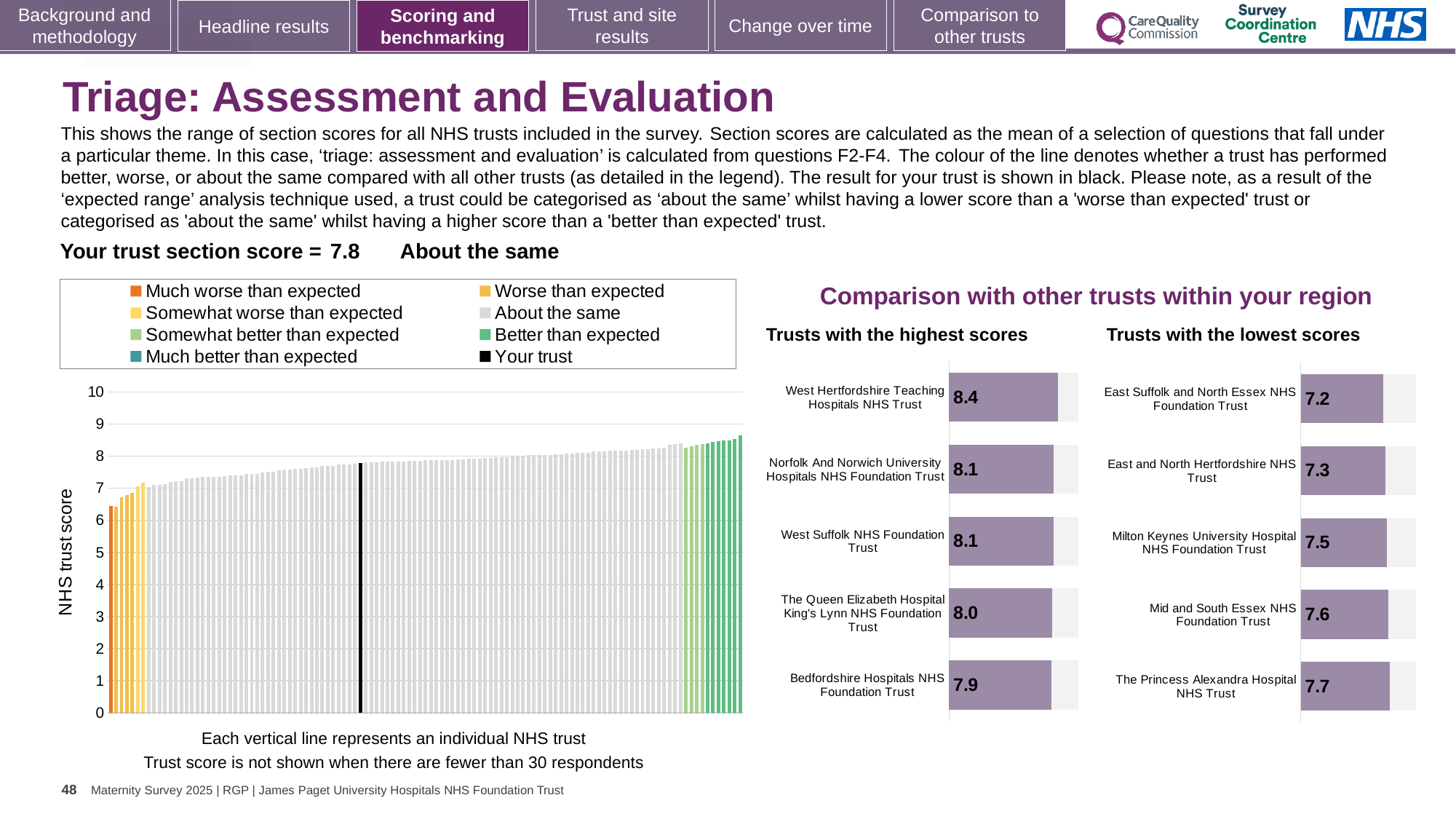
In the large chart on the left, is the value of the leftmost (orange) bar greater or less than 7? less In the 'Trusts with the highest scores' chart, which trust has the highest score? West Hertfordshire Teaching Hospitals NHS Trust In the 'Trusts with the highest scores' chart, what is the score for West Hertfordshire Teaching Hospitals NHS Trust? 8.4 How many entries does the legend above the large chart on the left list? 8 In the 'Trusts with the highest scores' chart, what is the difference between the scores of West Hertfordshire Teaching Hospitals NHS Trust and Bedfordshire Hospitals NHS Foundation Trust? 0.5 In the 'Trusts with the lowest scores' chart, which has the larger score: East and North Hertfordshire NHS Trust or Mid and South Essex NHS Foundation Trust? Mid and South Essex NHS Foundation Trust In the large chart on the left, what is the section score for your trust (the black bar)? 7.8 How many trusts are shown in the 'Trusts with the lowest scores' chart? 5 In the large chart on the left, do the bar values rise or fall from left to right? rise In the 'Trusts with the lowest scores' chart, what is the score for Milton Keynes University Hospital NHS Foundation Trust? 7.5 In the 'Trusts with the lowest scores' chart, which trust has the lowest score? East Suffolk and North Essex NHS Foundation Trust What type of chart is the large chart on the left? bar chart